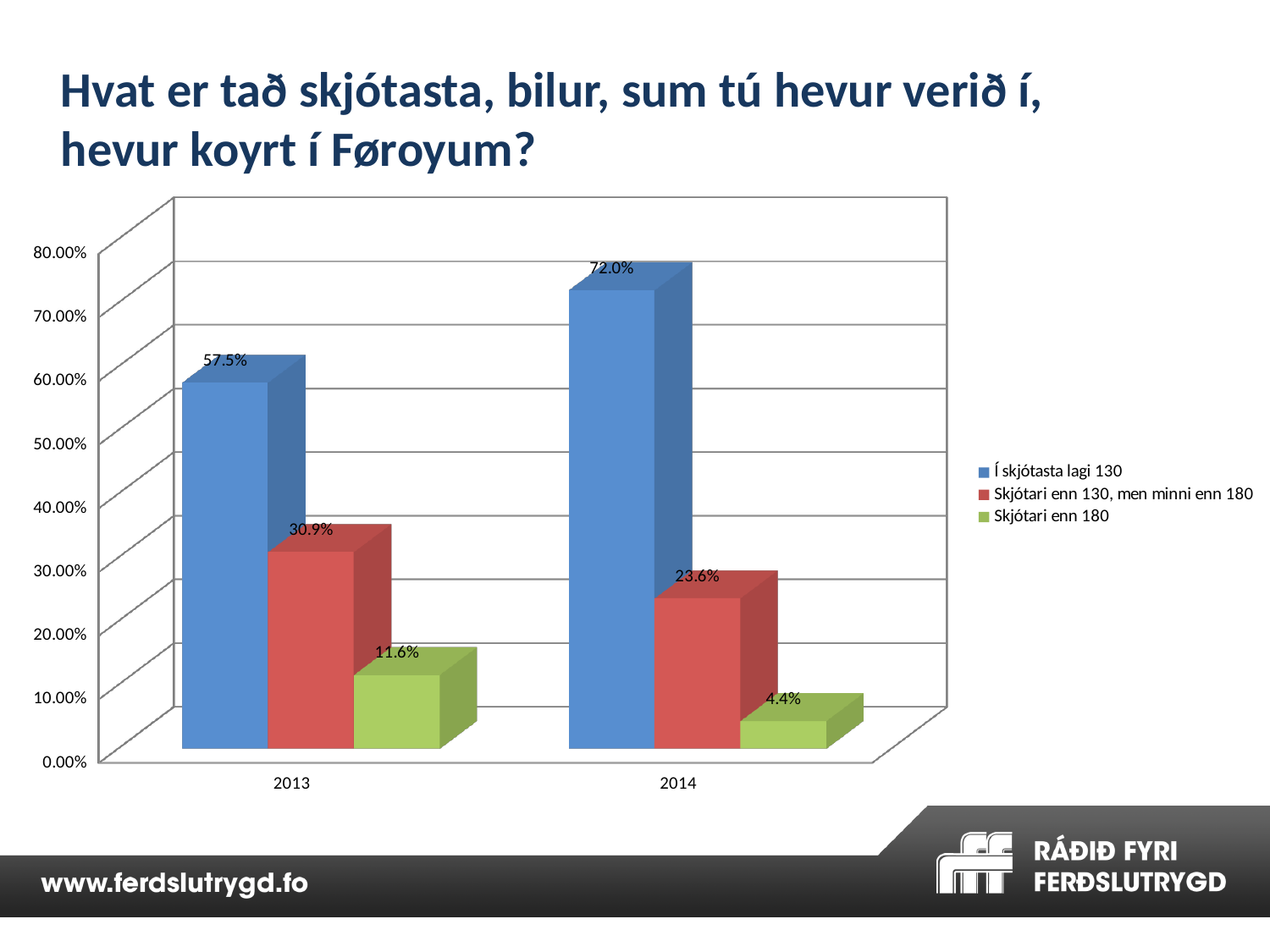
How many series does the legend list? 3 What is the value for 'Í skjótasta lagi 130' in 2014? 72.0% Which series has the lowest value in 2013? Skjótari enn 180 What is the value for 'Skjótari enn 130, men minni enn 180' in 2013? 30.9% What kind of chart is shown on the slide? Bar chart How many year categories are shown on the x axis? 2 What is the difference between the 'Í skjótasta lagi 130' values for 2014 and 2013? 14.5% Which series has the highest value in 2014? Í skjótasta lagi 130 Which is larger: 'Skjótari enn 130, men minni enn 180' in 2013 or in 2014? 2013 Does the value for 'Skjótari enn 180' rise or fall from 2013 to 2014? Fall What is the value for 'Í skjótasta lagi 130' in 2013? 57.5% What is the value for 'Skjótari enn 180' in 2014? 4.4%